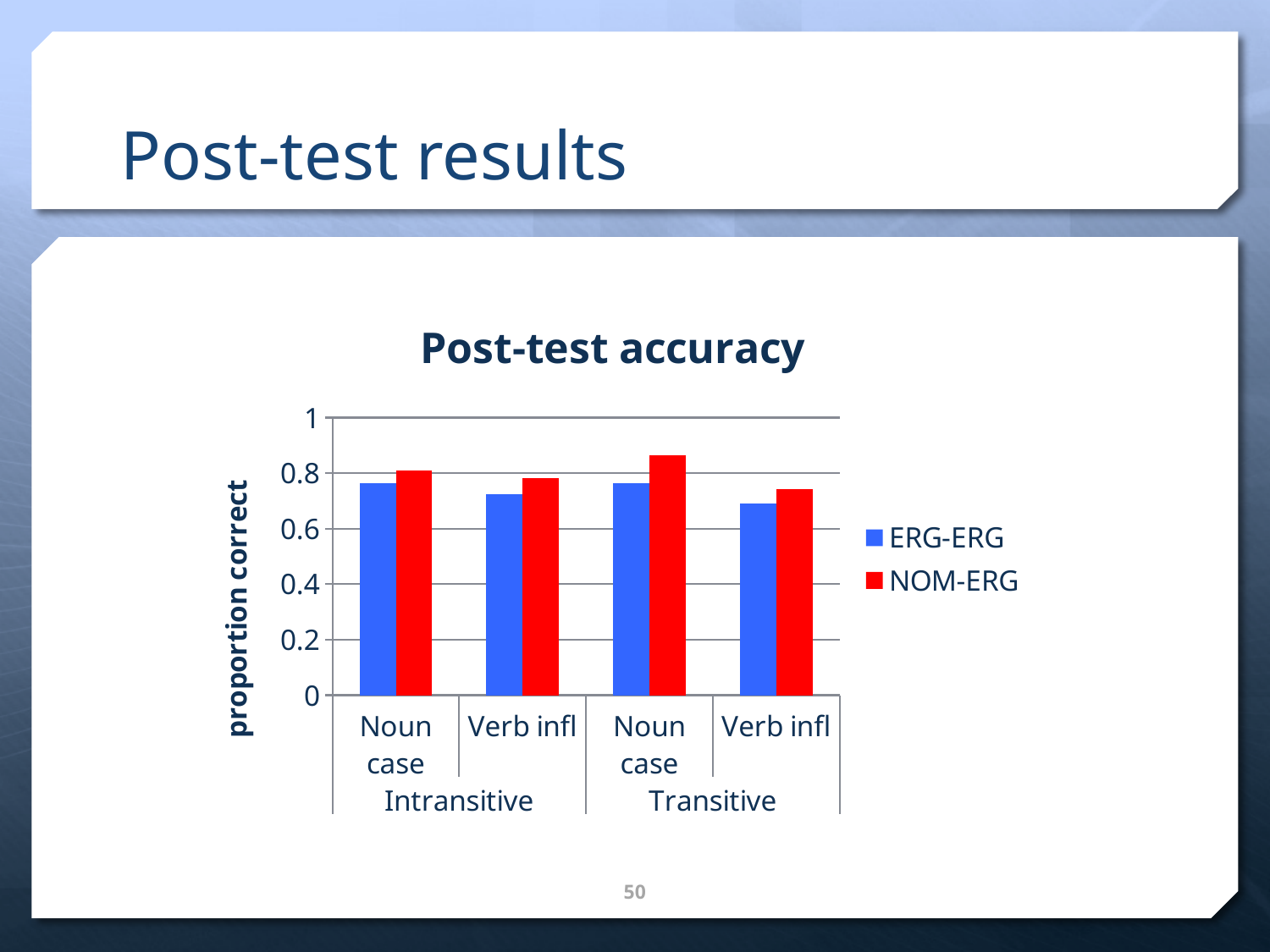
Which series has the higher value for Intransitive Verb infl, ERG-ERG or NOM-ERG? NOM-ERG What kind of chart is shown on the slide? bar chart Which series has the higher value for Transitive Noun case, ERG-ERG or NOM-ERG? NOM-ERG What is the label on the y axis? proportion correct How many series does the legend list? 2 Which series has the higher value for Transitive Verb infl, ERG-ERG or NOM-ERG? NOM-ERG Is the ERG-ERG value for Intransitive Noun case greater or less than 0.6? greater Is the ERG-ERG value for Transitive Verb infl greater or less than 0.8? less What is the title of the chart? Post-test accuracy For which category is the NOM-ERG value highest? Transitive Noun case How many categories are plotted along the x axis? 4 Is the NOM-ERG value for Transitive Noun case greater or less than 0.8? greater